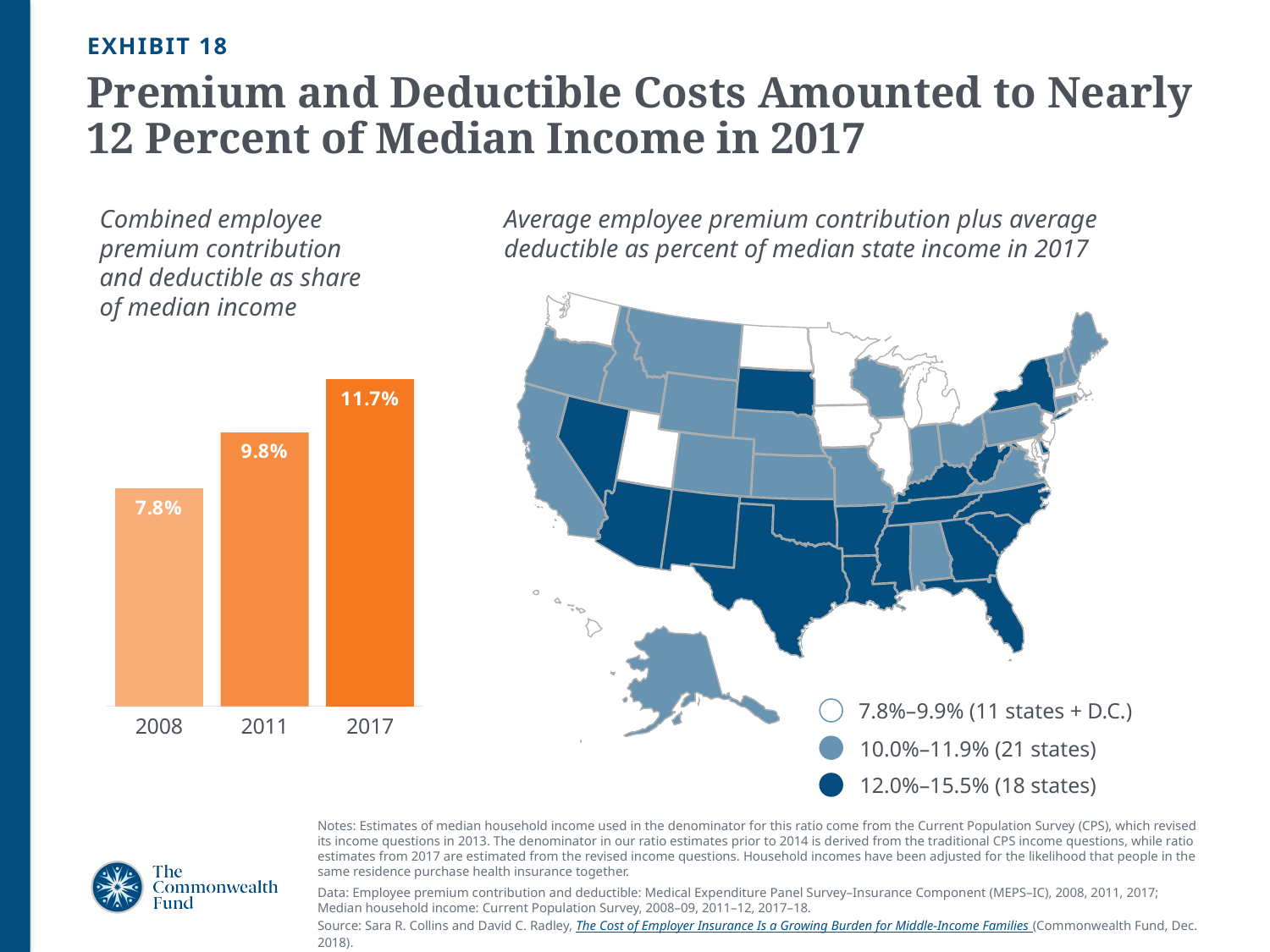
In the bar chart on the left, which year has the highest value? 2017 According to the map legend on the right, how many states fall in the 12.0%–15.5% category? 18 states In the bar chart on the left, is the value for 2011 larger or smaller than the value for 2017? smaller In the bar chart on the left, what value is shown for 2017? 11.7% What type of chart is shown on the left of the slide? bar chart In the bar chart on the left, do the values rise or fall from 2008 to 2017? rise In the bar chart on the left, what was the combined employee premium contribution and deductible as a share of median income in 2008? 7.8% In the bar chart on the left, what value is shown for 2011? 9.8% In the bar chart on the left, which year has the lowest value? 2008 How many years are shown in the bar chart on the left? 3 In the bar chart on the left, what is the difference between the 2011 and 2008 values? 2.0 percentage points In the bar chart on the left, what is the difference between the 2017 and 2008 values? 3.9 percentage points